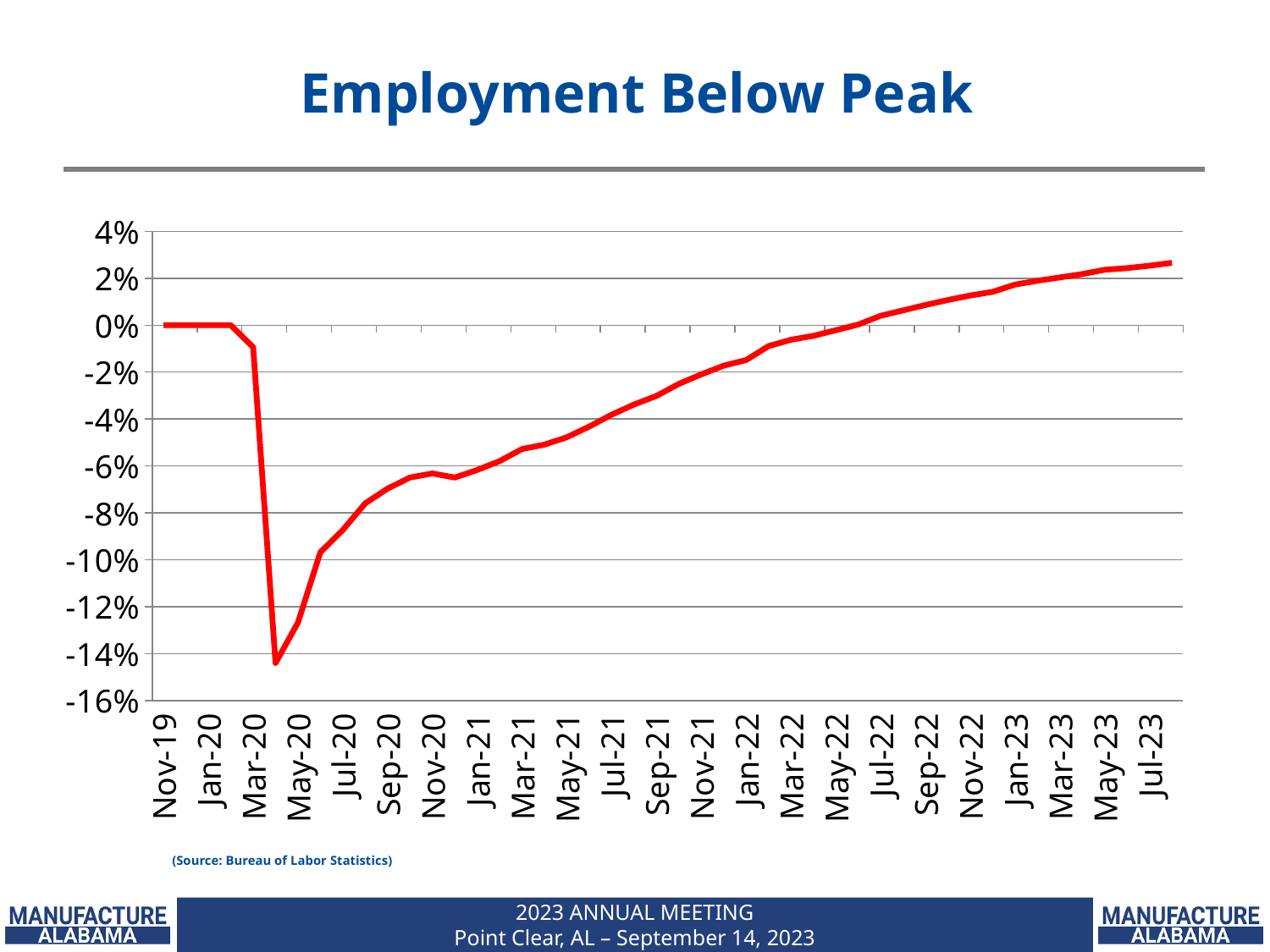
Is the value for May-23 greater or less than 2%? greater Which labeled month has the highest value on the chart? Jul-23 What kind of chart is shown on the slide? Line chart What is the value for Jan-20? 0% In which year does the lowest point of the line occur? 2020 What is the title of the chart? Employment Below Peak Is the lowest value on the chart greater or less than -14%? less Which is larger, the value for Jul-20 or the value for Jul-21? Jul-21 What is the value for Nov-19? 0% Is the value for Sep-20 greater or less than -8%? greater From May-20 to Jul-23, does the line generally rise or fall? rise